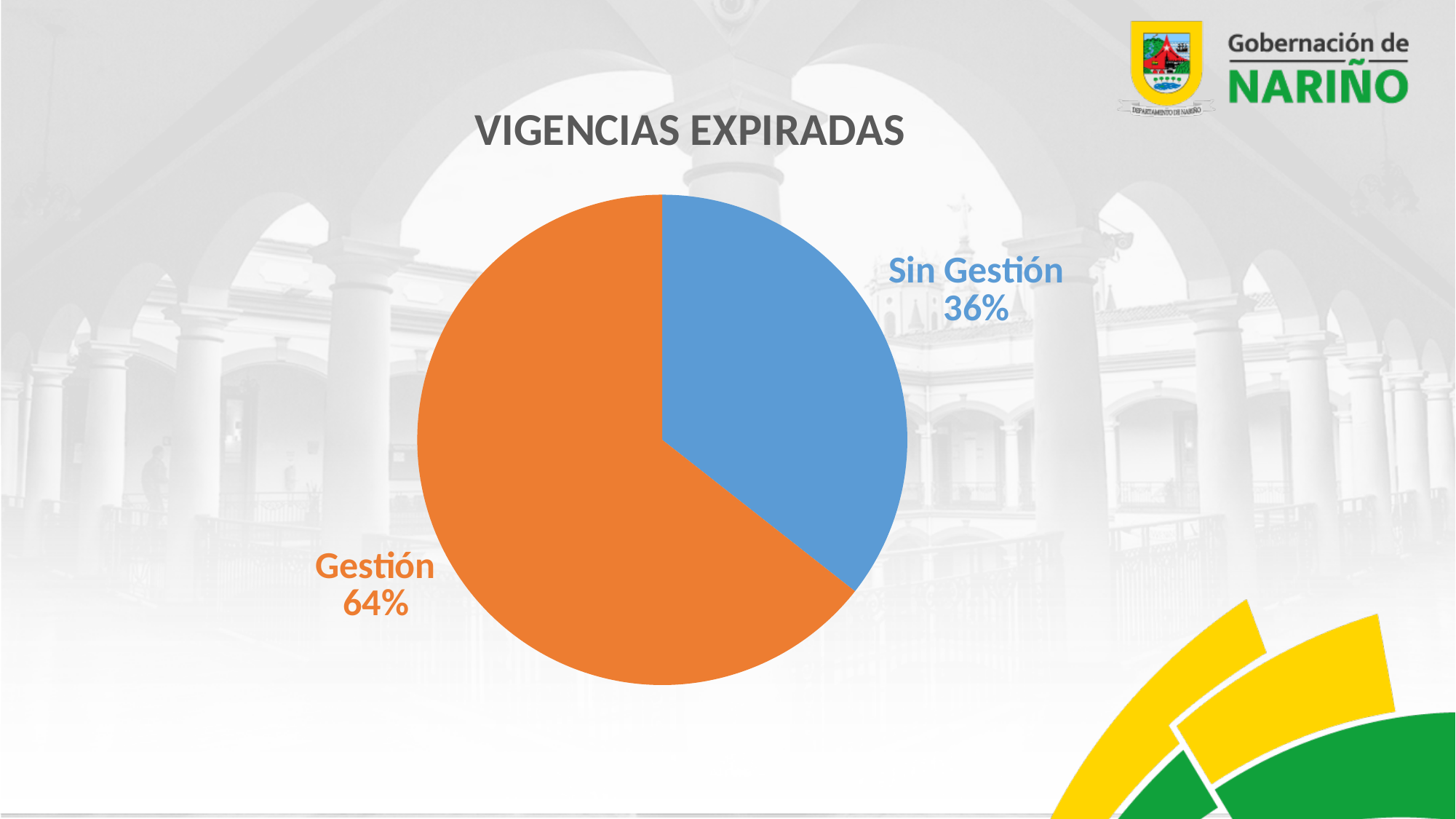
What share of the pie does Sin Gestión represent? 36% How many slices does the pie chart have? 2 What percentage is shown for Sin Gestión? 36% Which slice is the largest? Gestión Which slice is the smallest? Sin Gestión What kind of chart is shown on the slide? Pie chart What percentage is shown for Gestión? 64% Which is larger, Gestión or Sin Gestión? Gestión What is the title of the chart? VIGENCIAS EXPIRADAS What colour is the Gestión slice? Orange What is the difference in percentage points between Gestión and Sin Gestión? 28